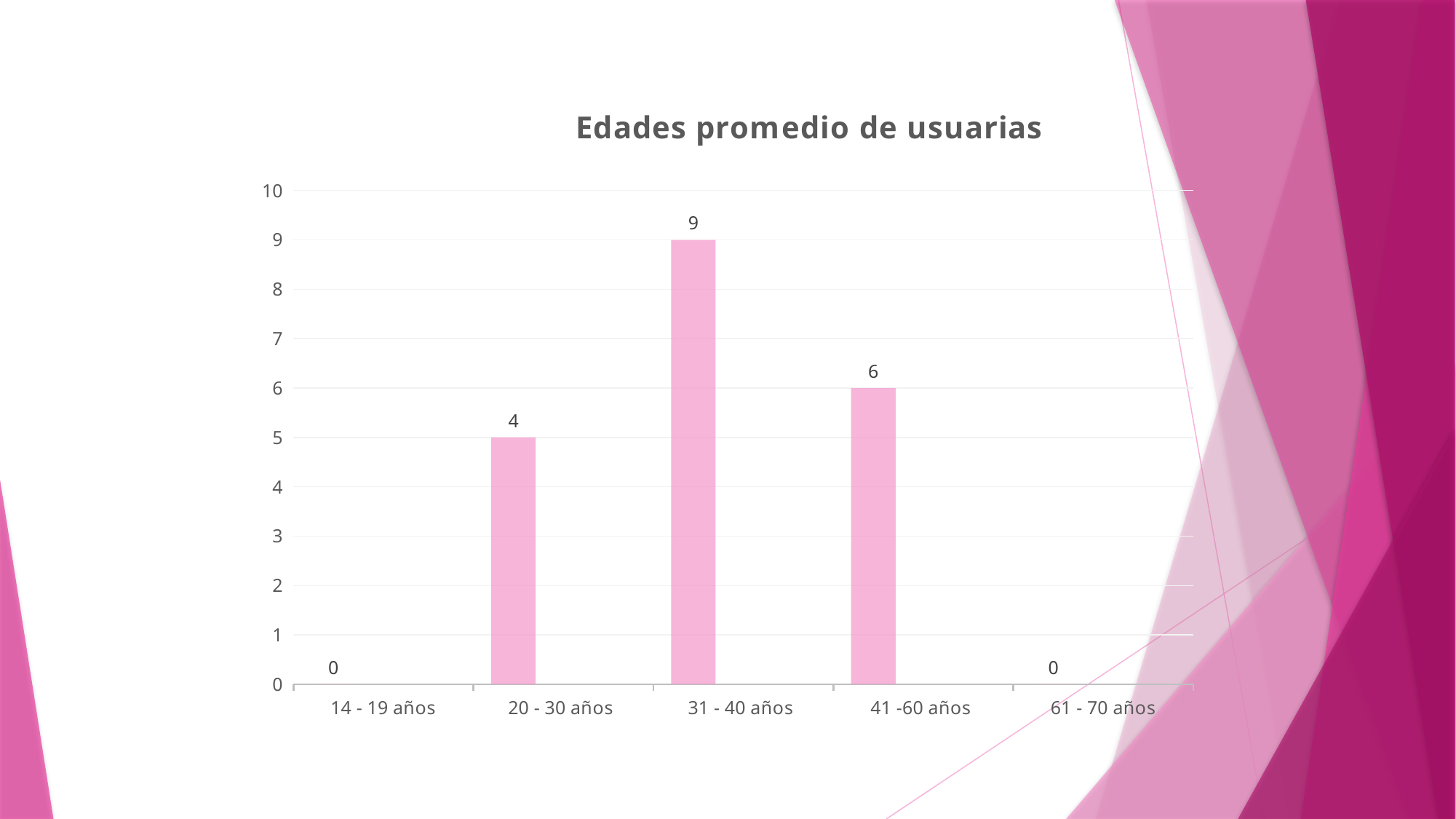
What kind of chart is shown on the slide? bar chart How many age categories are shown on the x axis? 5 Is the value for 31 - 40 años greater or less than 5? greater What is the difference between the values for 41 -60 años and 20 - 30 años? 2 Which age group has the highest value? 31 - 40 años What is the value for 41 -60 años? 6 What is the value for 14 - 19 años? 0 Which is larger, the value for 20 - 30 años or the value for 41 -60 años? 41 -60 años What is the value for 31 - 40 años? 9 What is the value for 20 - 30 años? 4 What is the difference between the values for 31 - 40 años and 41 -60 años? 3 What is the title of the chart? Edades promedio de usuarias